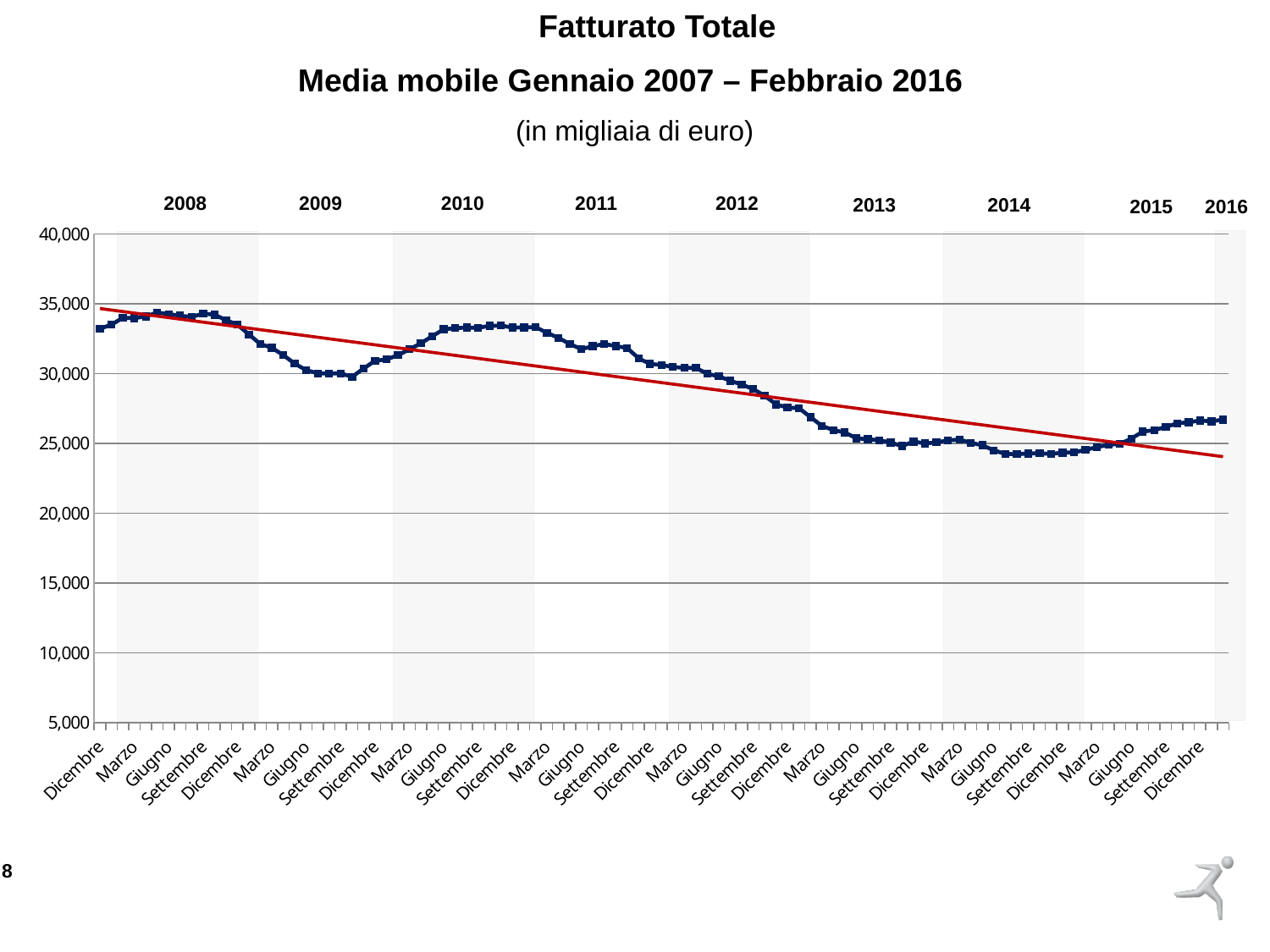
In which year does the blue line reach its lowest point? 2014 What is the title of the chart? Fatturato Totale In what unit are the values expressed, according to the subtitle? migliaia di euro Which is larger, the value for Giugno 2010 or the value for Giugno 2013? Giugno 2010 Does the red straight line slope upward or downward across the chart? downward Is the value for Dicembre 2014 greater or less than 25,000? less Is the value for Dicembre 2012 greater or less than 30,000? less Is the value for Giugno 2010 greater or less than 30,000? greater What kind of chart is shown on the slide? line chart What is the highest value shown on the vertical axis? 40,000 Does the blue line generally rise or fall from 2008 to 2016? fall